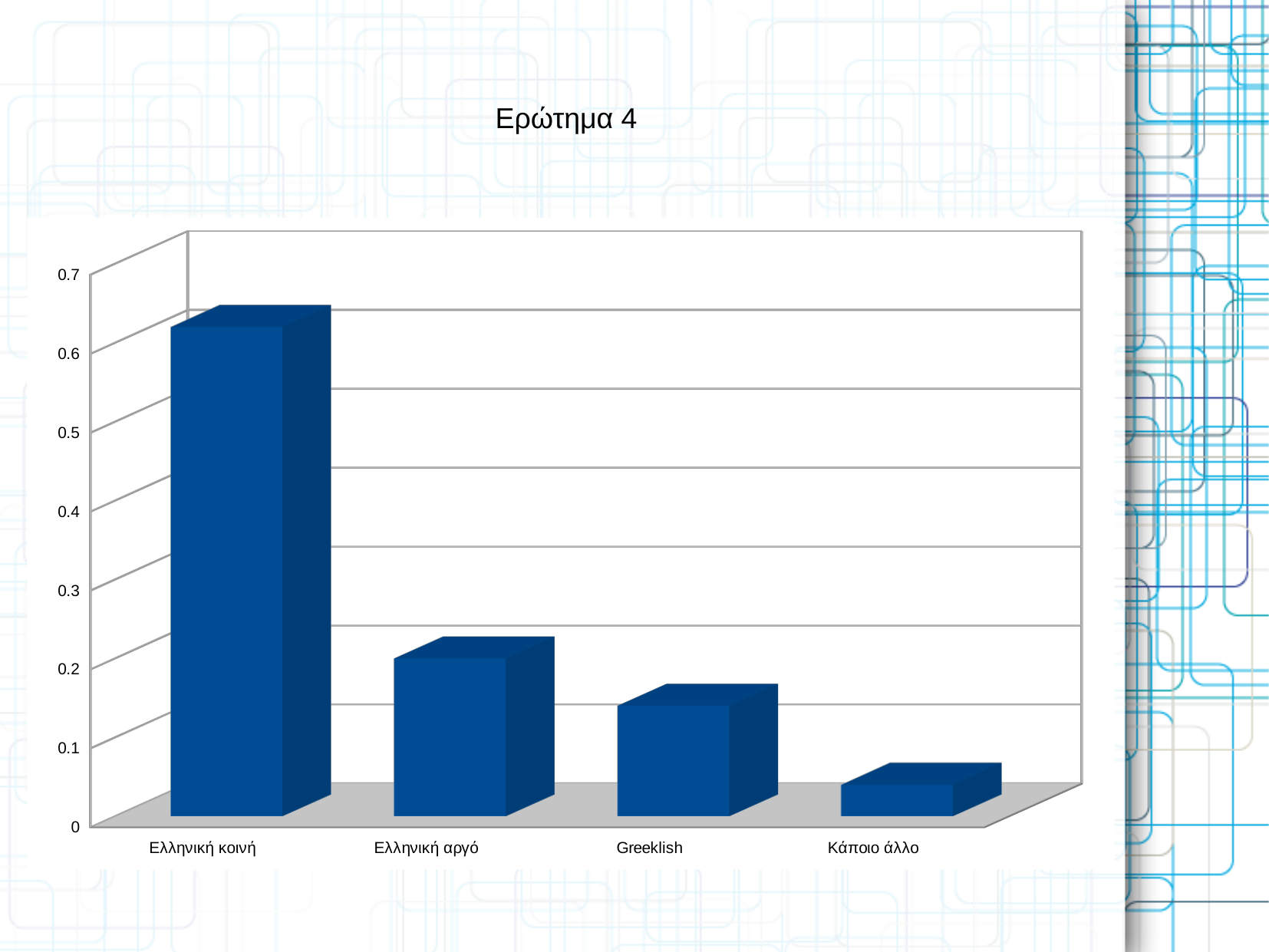
Is the value for Ελληνική αργό greater or less than 0.3? less What kind of chart is shown on the slide? bar chart Which category has the highest bar? Ελληνική κοινή Which is larger, the value for Ελληνική αργό or the value for Greeklish? Ελληνική αργό Is the value for Ελληνική κοινή greater or less than 0.5? greater Which is larger, the value for Ελληνική κοινή or the value for Κάποιο άλλο? Ελληνική κοινή Is the value for Κάποιο άλλο greater or less than 0.1? less How many categories are shown on the x axis of the chart? 4 Which category has the lowest bar? Κάποιο άλλο Do the bar values rise or fall from left to right along the x axis? fall What is the title of the chart on the slide? Ερώτημα 4